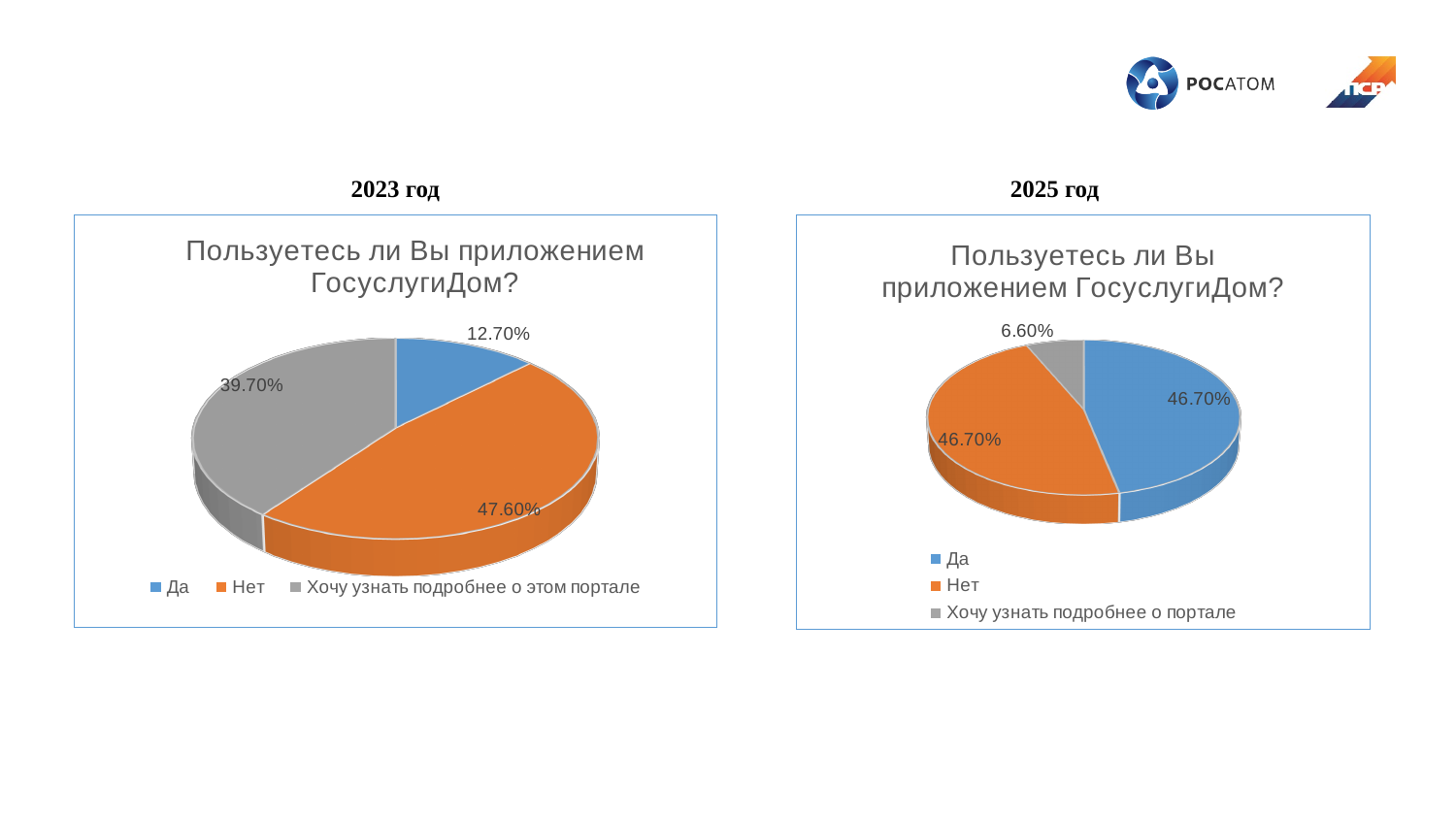
In the 2023 chart, what percentage of respondents answered "Да"? 12.70% In the 2023 chart, what is the difference between the shares for "Нет" and "Да"? 34.90% In the 2025 chart, which answer has the smallest share? Хочу узнать подробнее о портале In the 2023 chart, what share is labelled for "Хочу узнать подробнее о этом портале"? 39.70% What type of chart is used for the 2023 data? Pie chart In the 2025 chart, what share is labelled for "Хочу узнать подробнее о портале"? 6.60% In the 2023 chart, what percentage of respondents answered "Нет"? 47.60% In the 2023 chart, which is larger: the share for "Нет" or the share for "Хочу узнать подробнее о этом портале"? Нет How many categories does the legend of the 2025 chart list? 3 In the 2025 chart, what percentage of respondents answered "Да"? 46.70% In the 2023 chart, which answer has the largest share? Нет In the 2023 chart, which answer has the smallest share? Да